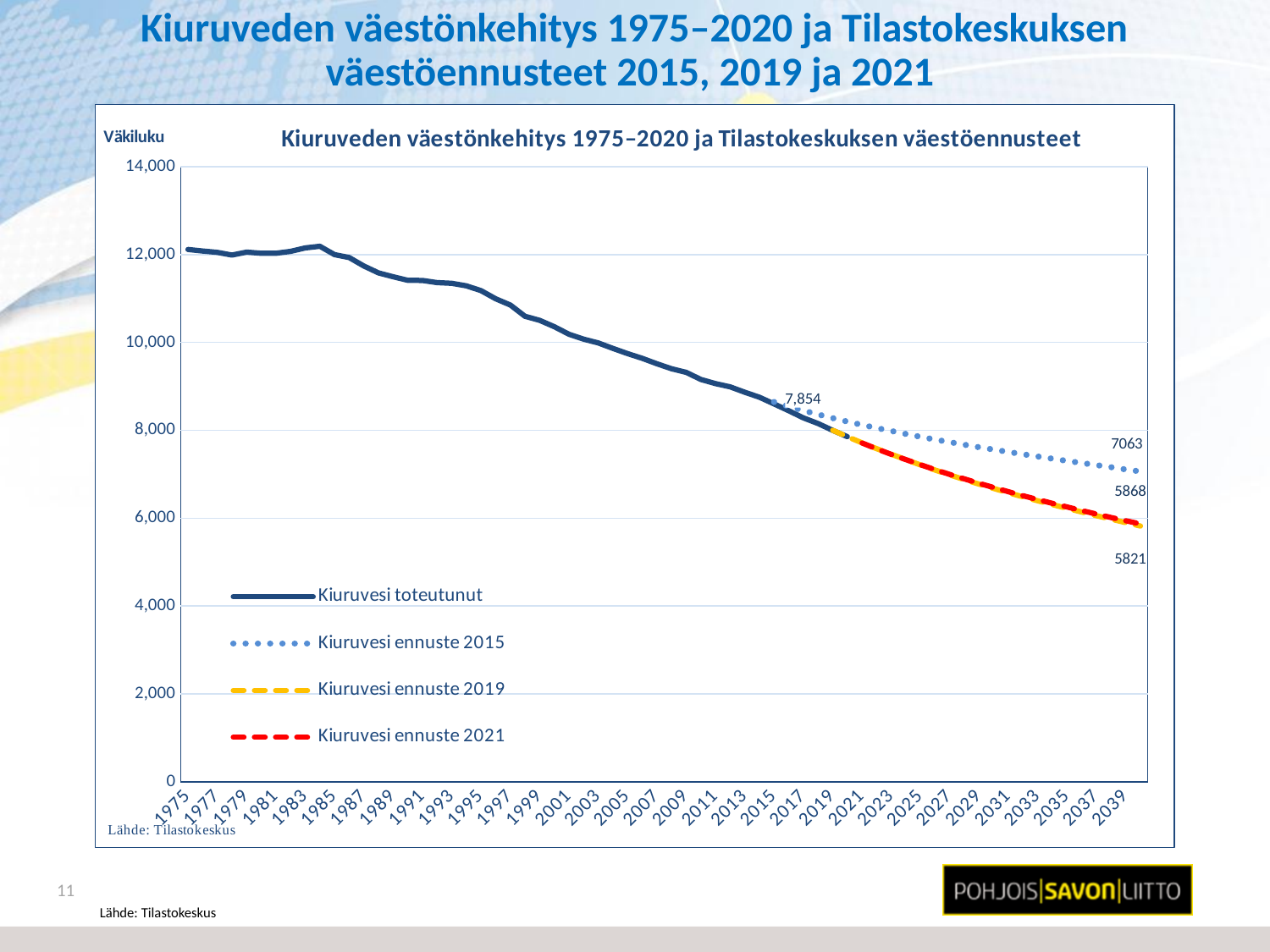
How many series does the legend list? 4 Does the Kiuruvesi toteutunut series rise or fall from 1975 to 2020? fall Which series has the highest value at the right end of the chart? Kiuruvesi ennuste 2015 What kind of chart is shown on the slide? line chart Which forecast series ends at a higher value, Kiuruvesi ennuste 2015 or Kiuruvesi ennuste 2021? Kiuruvesi ennuste 2015 Is the value of Kiuruvesi toteutunut in 1995 greater or less than 10,000? greater What label is shown on the vertical axis of the chart? Väkiluku What is the final labelled value of the Kiuruvesi ennuste 2019 series? 5821 What is the final labelled value of the Kiuruvesi ennuste 2015 series? 7063 What is the final labelled value of the Kiuruvesi ennuste 2021 series? 5868